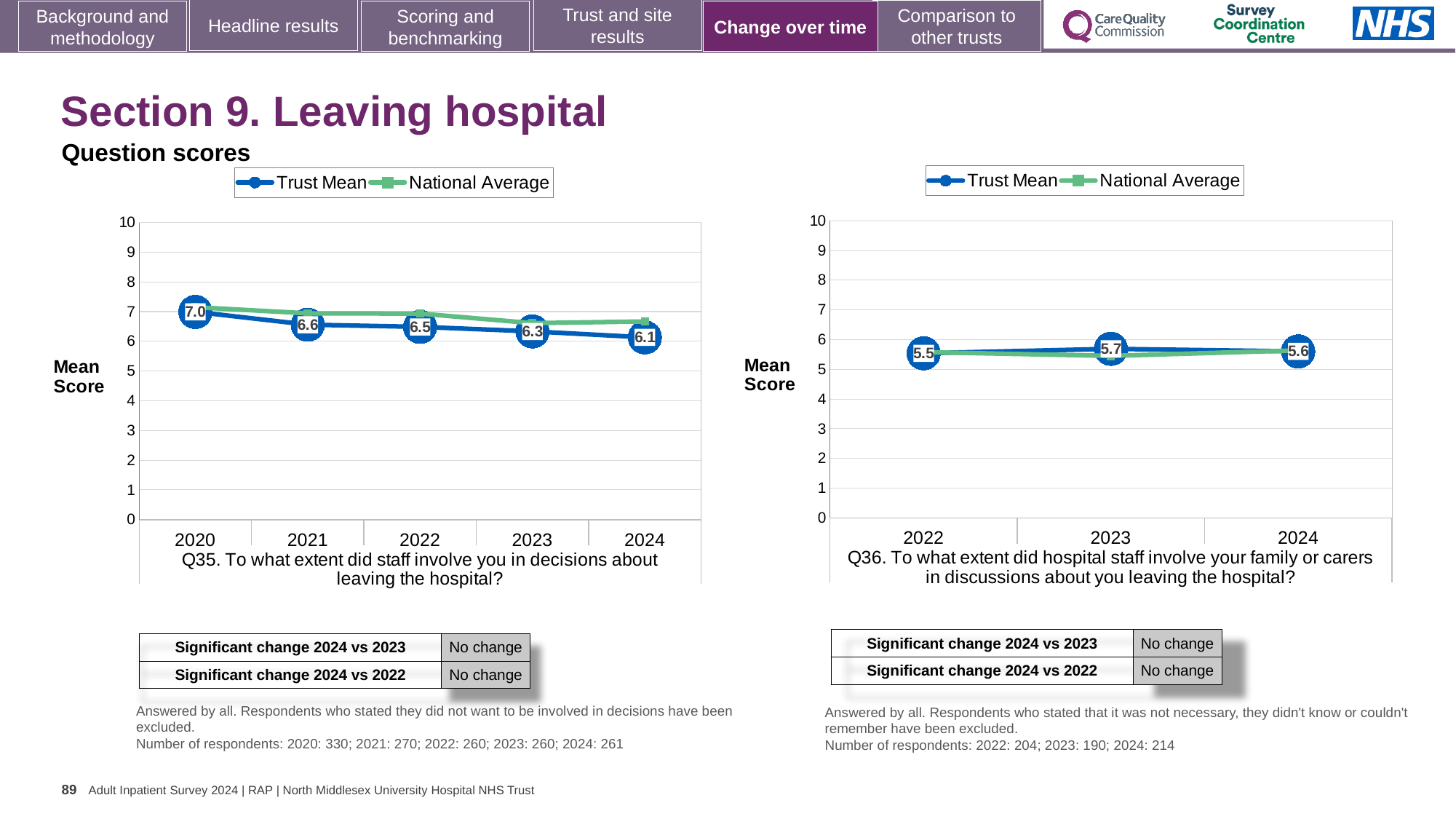
On the Q35 chart (left), what is the Trust Mean score for 2020? 7.0 On the Q36 chart (right), what is the Trust Mean score for 2023? 5.7 On the Q36 chart (right), is the Trust Mean score for 2024 greater or less than 6? less What type of chart is used for Q35 on the left? line chart On the Q35 chart (left), what is the difference between the Trust Mean scores for 2020 and 2024? 0.9 On the Q35 chart (left), how many years are plotted on the x axis? 5 On the Q35 chart (left), does the Trust Mean rise or fall from 2020 to 2024? fall On the Q35 chart (left), what is the Trust Mean score for 2024? 6.1 On the Q35 chart (left), which year has the lowest Trust Mean score? 2024 On the Q36 chart (right), how many series does the legend list? 2 On the Q35 chart (left), which year has the highest Trust Mean score? 2020 On the Q36 chart (right), which year has the lowest Trust Mean score? 2022